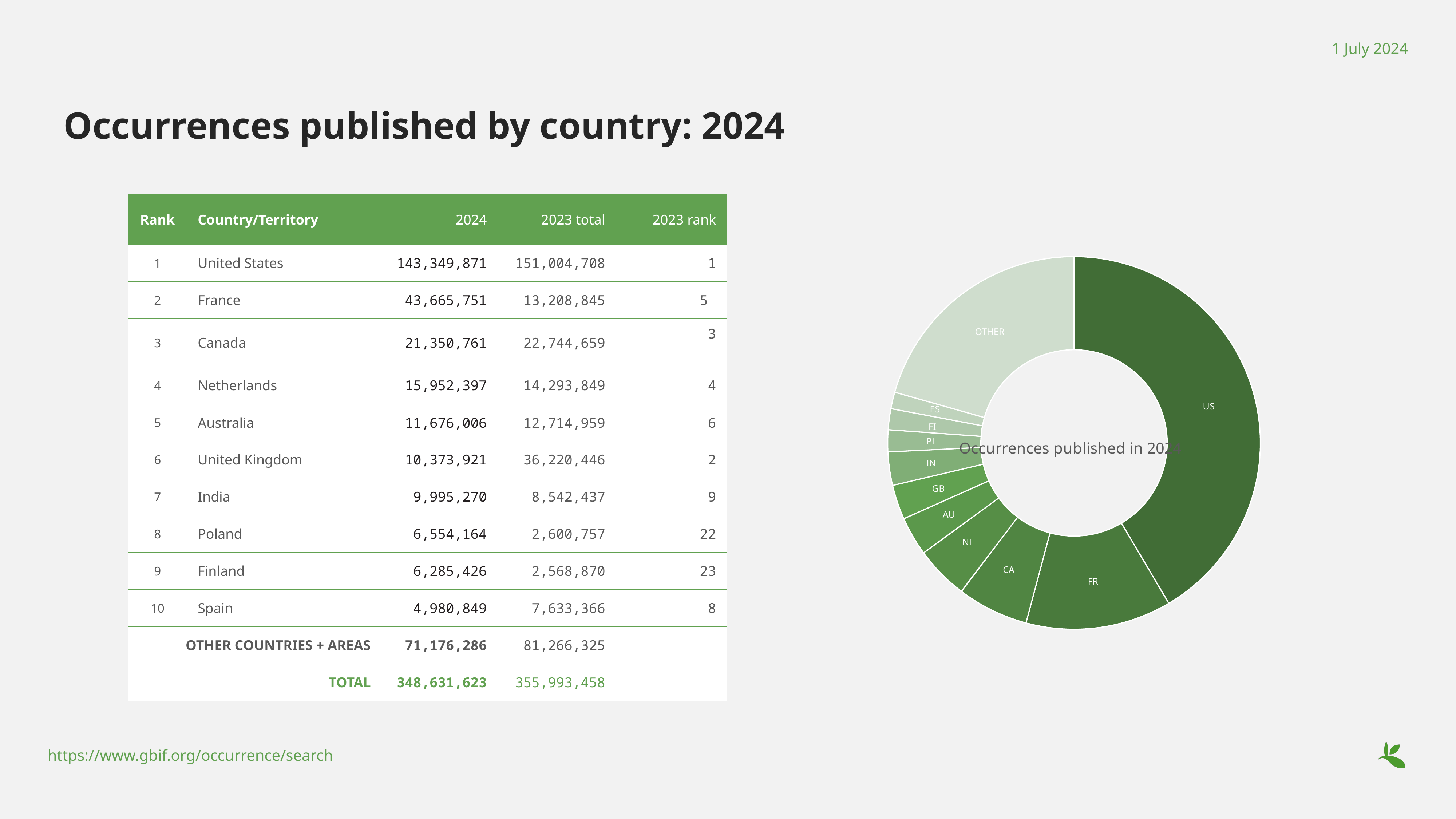
What is the difference between the US and FR 2024 values shown in the table? 99,684,120 What kind of chart is shown on the right of the slide? Donut (pie) chart What is the title printed in the centre of the donut chart? Occurrences published in 2024 In the donut chart, which slice is larger, OTHER or FR? OTHER What is the total of all 2024 occurrences represented by the donut chart, as given in the table? 348,631,623 What is the 2024 value for the US slice of the donut chart, as given in the table? 143,349,871 How many slices does the donut chart have? 11 Which named country slice of the donut chart is the smallest? ES Which slice of the donut chart is the largest? US What is the 2024 value for the OTHER slice of the donut chart, as given in the table? 71,176,286 What is the 2024 value for the FR slice of the donut chart, as given in the table? 43,665,751 In the donut chart, which slice is larger, FR or CA? FR